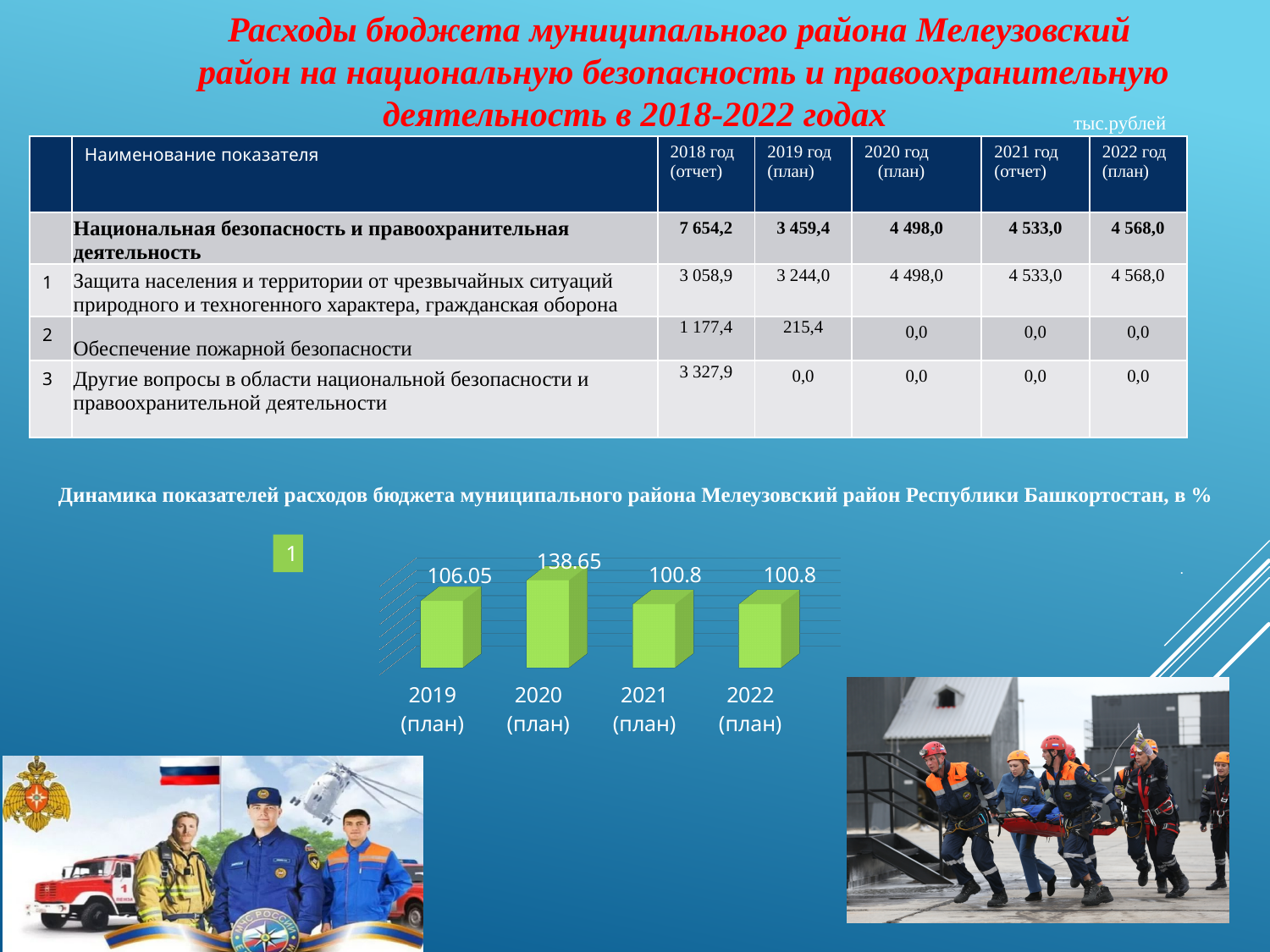
What is the value for 2019 (план) in the chart? 106.05 What is the value for 2020 (план) in the chart? 138.65 How many categories are shown on the x axis of the chart? 4 What kind of chart is shown on the slide? bar chart Do the values in the chart rise or fall from 2020 (план) to 2021 (план)? fall Which is larger, the value for 2019 (план) or the value for 2021 (план)? 2019 (план) What is the value for 2022 (план) in the chart? 100.8 What is the difference between the values for 2019 (план) and 2021 (план)? 5.25 Are the values for 2021 (план) and 2022 (план) the same? yes What is the difference between the values for 2020 (план) and 2019 (план)? 32.6 What colour are the bars in the chart? green Which category has the highest value in the chart? 2020 (план)